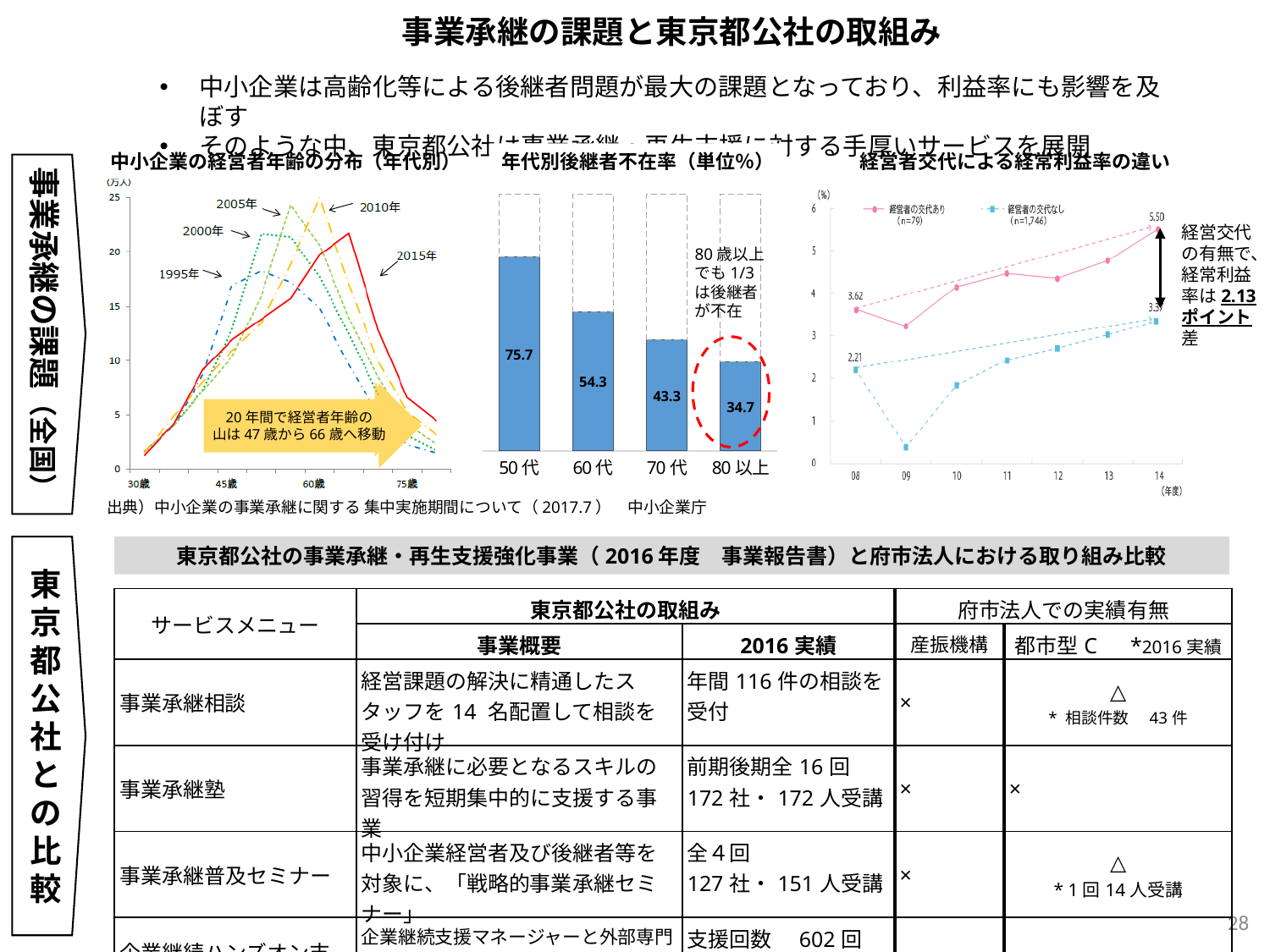
In the bar chart 年代別後継者不在率, what is the value for 80以上? 34.7 In the bar chart 年代別後継者不在率, which category has the highest value? 50代 In the right chart 経営者交代による経常利益率の違い, what is the value for 経営者の交代あり in 14? 5.50 What kind of chart is the middle chart 年代別後継者不在率? bar chart In the right chart 経営者交代による経常利益率の違い, what is the value for 経営者の交代なし in 08? 2.21 In the bar chart 年代別後継者不在率, do the values rise or fall from 50代 to 80以上? fall In the right chart 経営者交代による経常利益率の違い, how many series does the legend list? 2 In the bar chart 年代別後継者不在率, how many categories are shown on the x axis? 4 In the bar chart 年代別後継者不在率, what is the value for 50代? 75.7 In the left chart 中小企業の経営者年齢の分布, how many year series are plotted? 5 In the bar chart 年代別後継者不在率, which category has the lowest value? 80以上 In the bar chart 年代別後継者不在率, what is the difference between the values for 60代 and 70代? 11.0